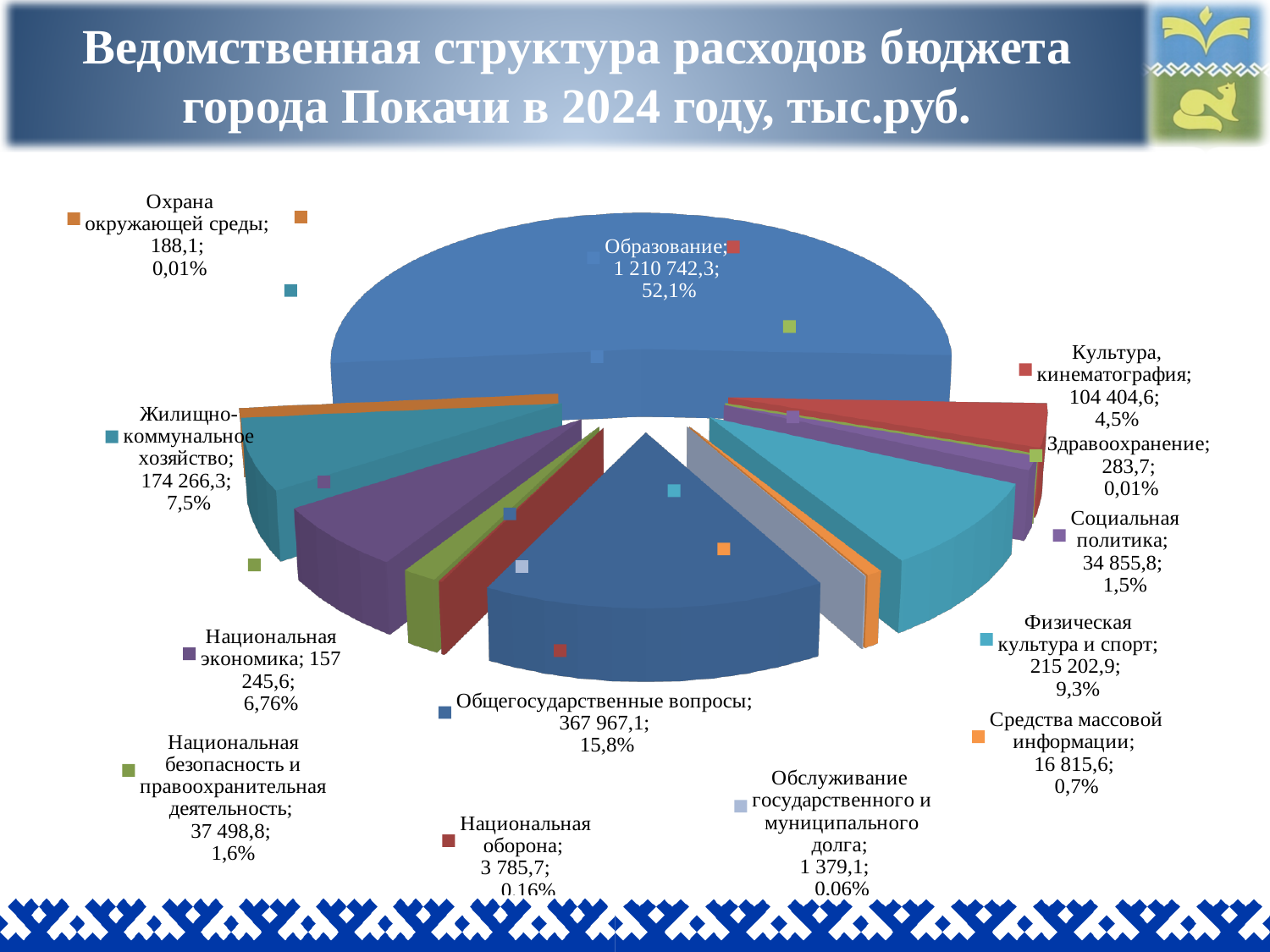
What is the value for Физическая культура и спорт? 215 202,9 What share of the pie does Национальная экономика represent? 6,76% What is the value for Образование? 1 210 742,3 What is the difference between the values for Общегосударственные вопросы and Физическая культура и спорт? 152 764,2 What is the title of the slide? Ведомственная структура расходов бюджета города Покачи в 2024 году, тыс.руб. What kind of chart is shown on the slide? pie chart What share of the pie does Общегосударственные вопросы represent? 15,8% Which category has the largest value? Образование What is the value for Жилищно-коммунальное хозяйство? 174 266,3 Which category has the smallest value? Охрана окружающей среды Which is larger, the value for Культура, кинематография or the value for Социальная политика? Культура, кинематография How many categories are labelled on the pie chart? 13